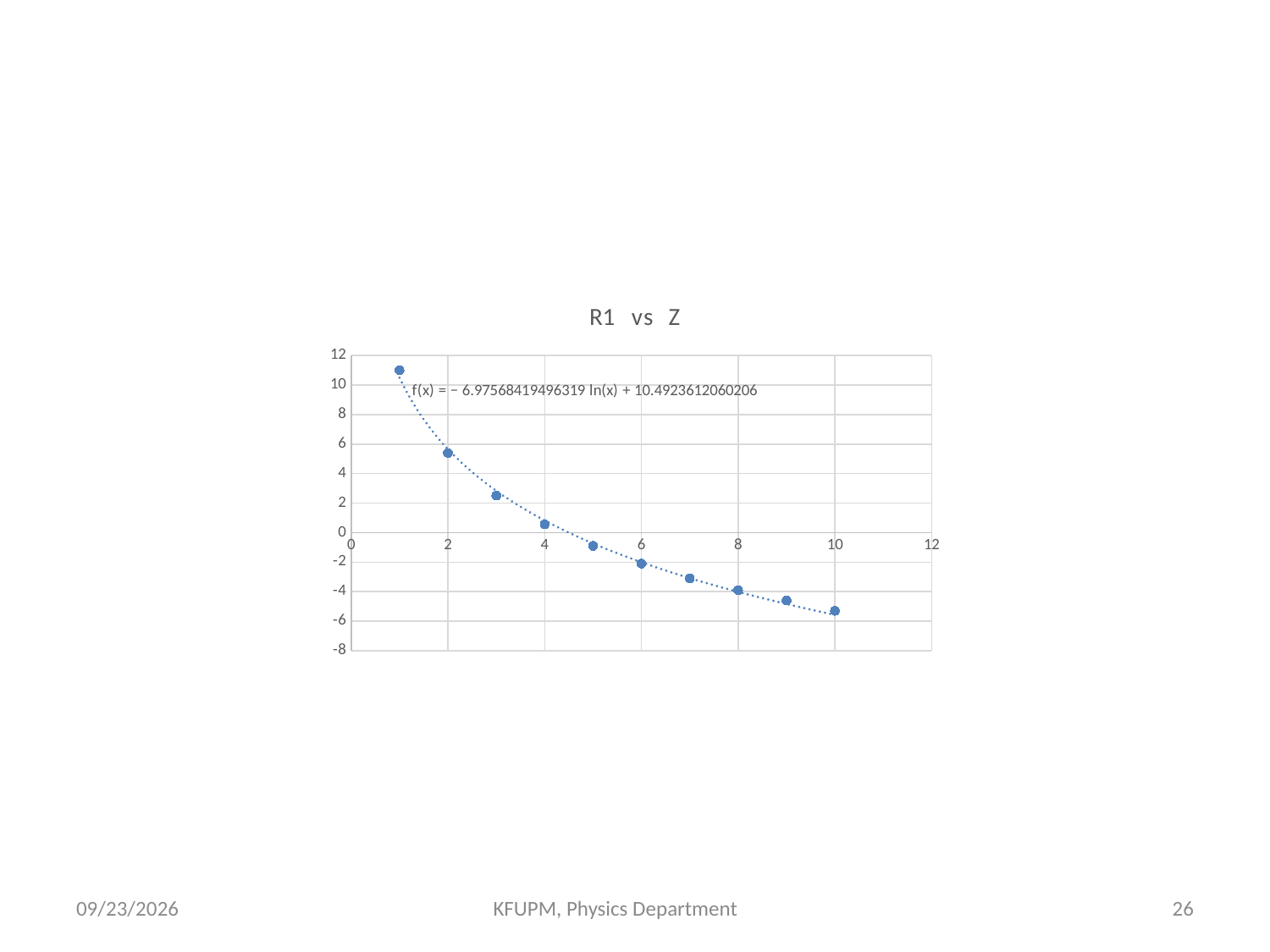
Which point has the larger value, the one at x = 3 or the one at x = 7? x = 3 How many data points are plotted in the chart? 10 Is the value of the point at x = 2 greater or less than 4? greater Is the value of the point at x = 5 greater or less than 0? less Is the value of the point at x = 10 greater or less than -4? less What kind of chart is shown on the slide? scatter chart What is the title of the chart? R1 vs Z Do the plotted values rise or fall as x increases along the x axis? fall What trendline equation is displayed on the chart? f(x) = − 6.97568419496319 ln(x) + 10.4923612060206 At which x value is the plotted point lowest? 10 At which x value is the plotted point highest? 1